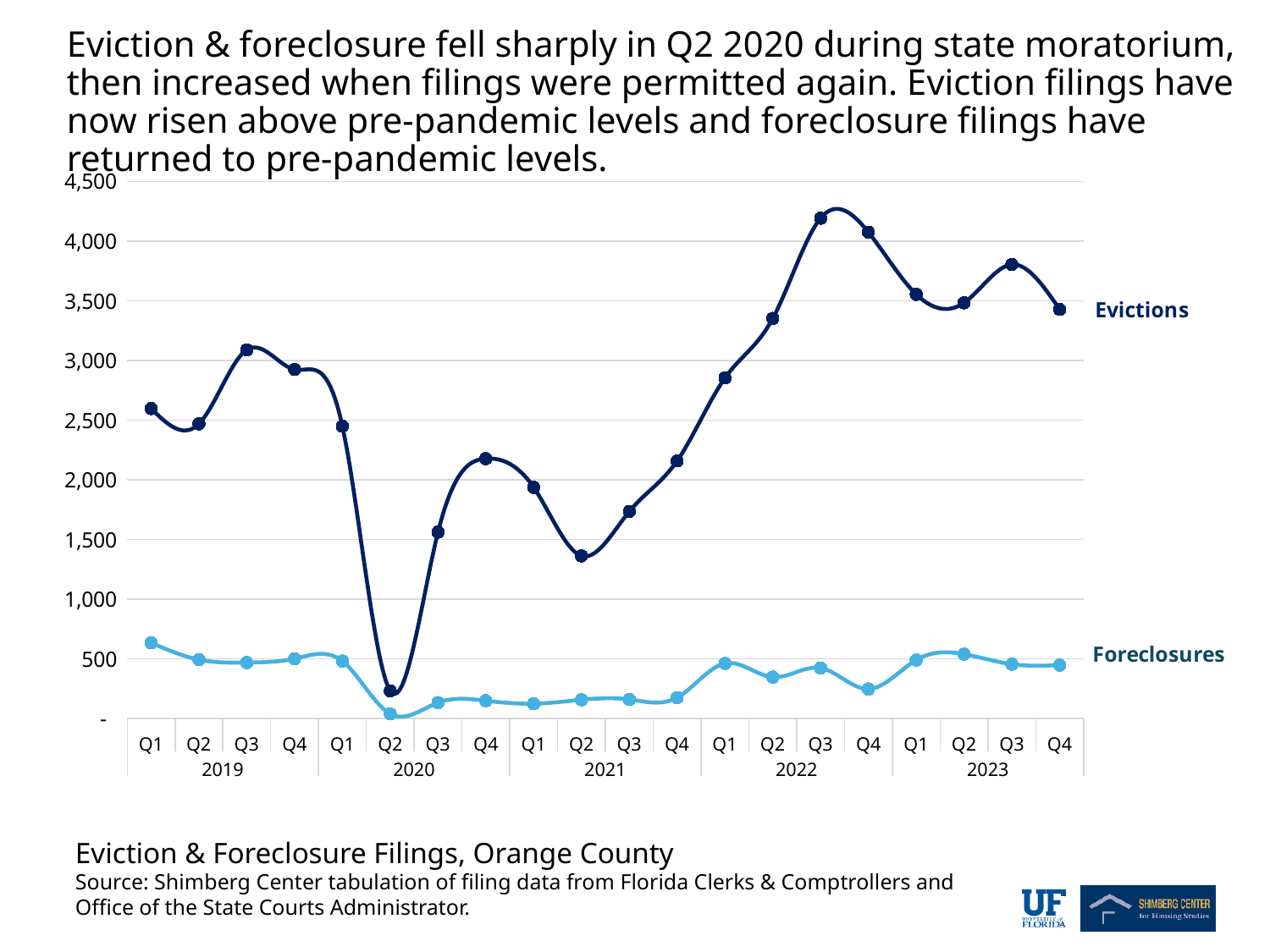
Is the value for Evictions in Q2 2020 greater or less than 500? less Is the value for Foreclosures in Q1 2019 greater or less than 500? greater Is the value for Evictions in Q2 2021 greater or less than 1,500? less In which quarter do Evictions reach their highest value? Q3 2022 How many series are plotted on the chart? 2 Do Evictions rise or fall from Q2 2020 to Q4 2020? Rise What kind of chart is shown on the slide? Line chart In which quarter do Evictions reach their lowest value? Q2 2020 In which quarter do Foreclosures reach their lowest value? Q2 2020 How many quarterly data points does each line have? 20 Which is larger, Evictions in Q3 2022 or Evictions in Q4 2022? Q3 2022